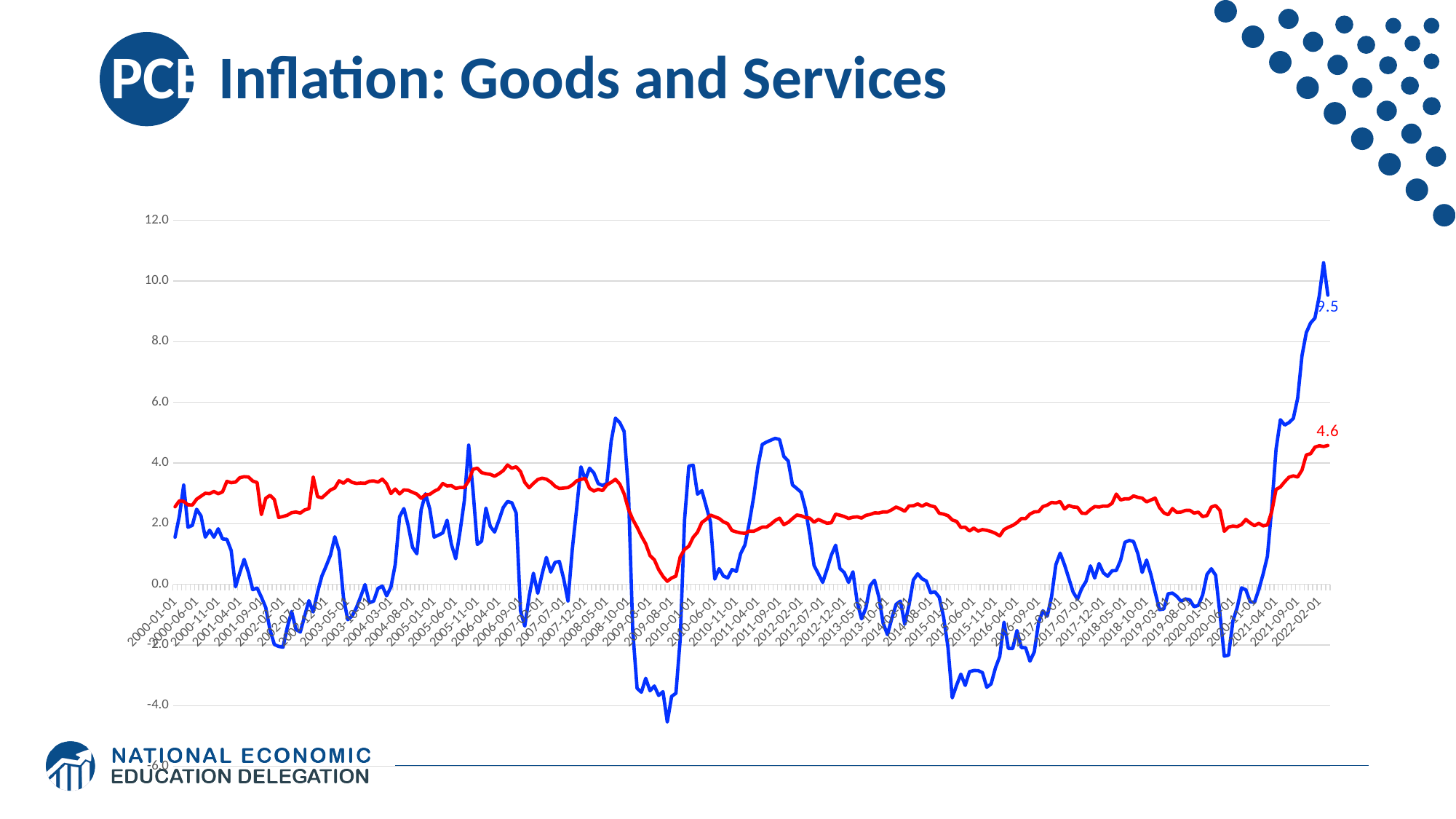
Which line reaches the lowest value anywhere on the chart, the blue line or the red line? blue line What is the difference between the labelled final values of the blue line (9.5) and the red line (4.6)? 4.9 At the end of the series, which line has the larger value, the blue line or the red line? blue line Is the peak value of the blue line greater or less than 10.0? greater Does the blue line rise or fall between 2020-06-01 and 2022-02-01? rise What is the labelled final value of the blue line? 9.5 What kind of chart is shown on the slide? line chart How many lines are plotted on the chart? 2 What is the labelled final value of the red line? 4.6 What is the title of the chart? Inflation: Goods and Services Which line reaches the highest value anywhere on the chart, the blue line or the red line? blue line Is the lowest value of the blue line (around 2009) greater or less than -4.0? less